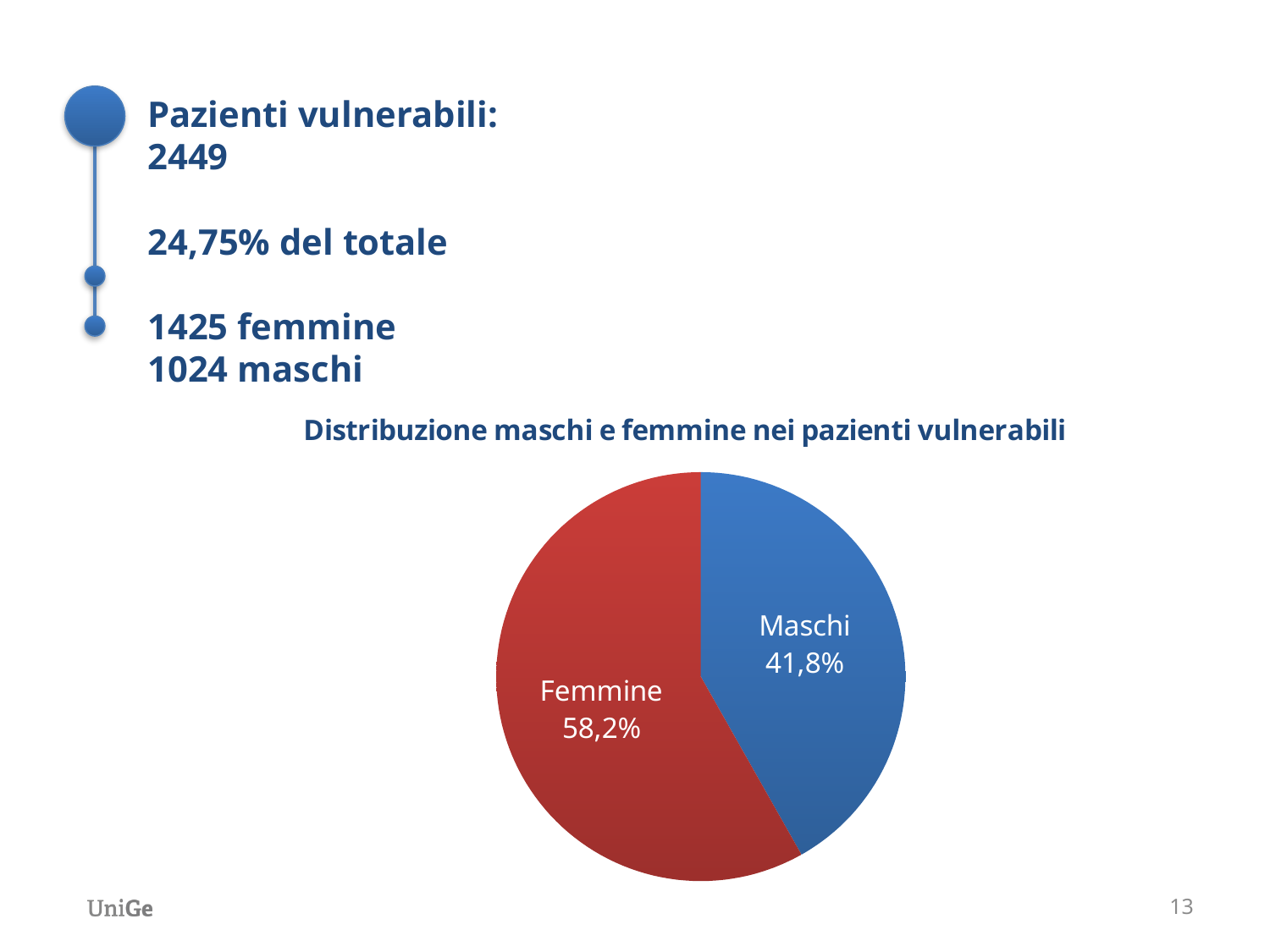
What share of the pie does the Maschi slice represent? 41,8% Which slice of the pie is the largest? Femmine What colour is the Maschi slice? blue What share of the pie does the Femmine slice represent? 58,2% How many slices does the pie chart have? 2 What is the title of the chart? Distribuzione maschi e femmine nei pazienti vulnerabili What is the difference in percentage points between the Femmine and Maschi slices? 16,4 Which is larger, the Femmine slice or the Maschi slice? Femmine Which slice of the pie is the smallest? Maschi What kind of chart is shown on the slide? pie chart